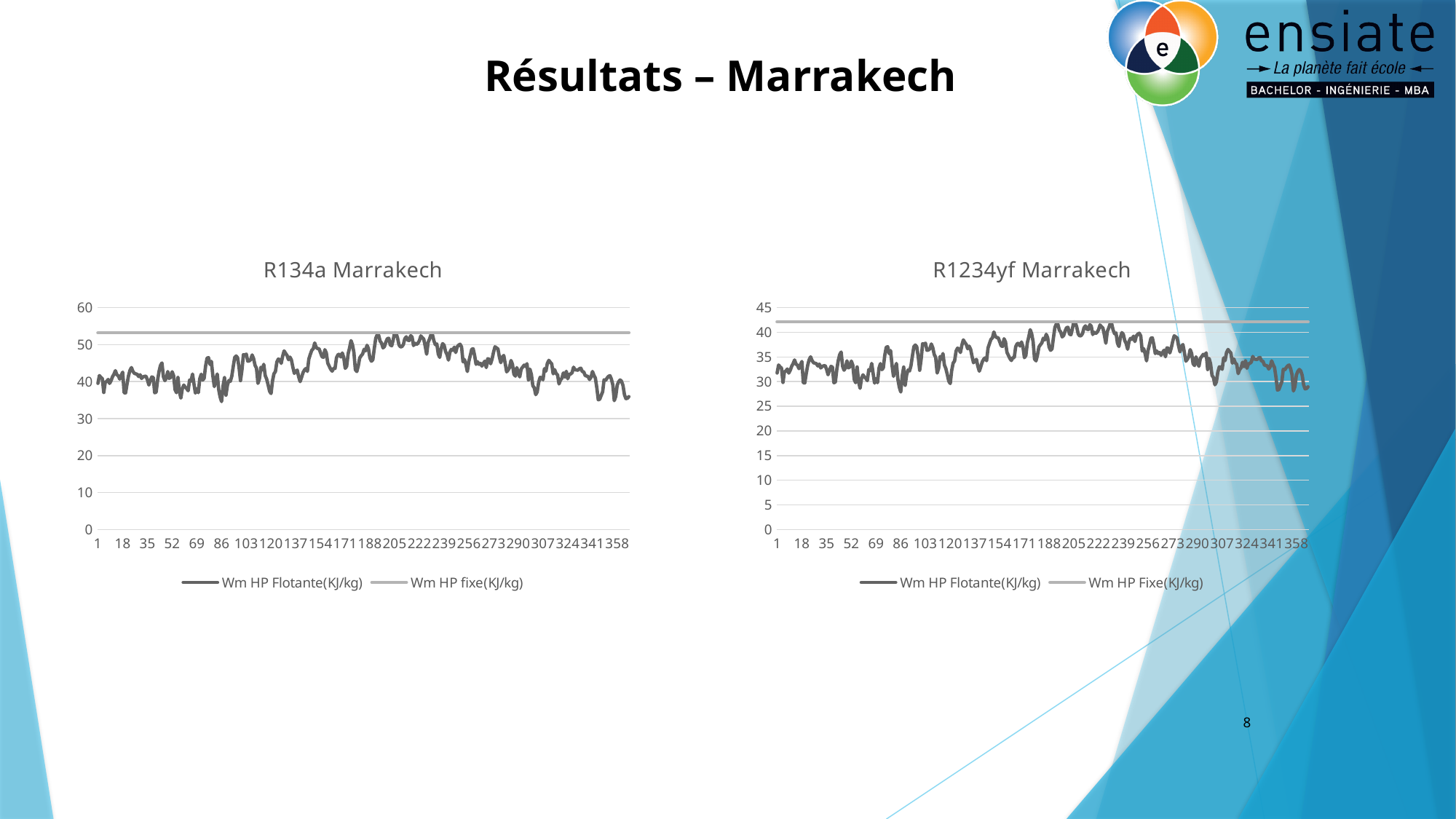
How many series does the legend of the R1234yf Marrakech chart list? 2 In the R134a Marrakech chart, which series has the higher value at point 1, Wm HP Flotante(KJ/kg) or Wm HP fixe(KJ/kg)? Wm HP fixe(KJ/kg) What are the two legend entries of the R1234yf Marrakech chart? Wm HP Flotante(KJ/kg) and Wm HP Fixe(KJ/kg) What kind of chart is the R1234yf Marrakech chart? line chart In the R1234yf Marrakech chart, does the Wm HP Flotante(KJ/kg) line generally rise or fall between point 205 and point 358? fall In the R134a Marrakech chart, is the value of Wm HP fixe(KJ/kg) greater or less than 50? greater In the R1234yf Marrakech chart, is the value of Wm HP Flotante(KJ/kg) at point 358 greater or less than 20? greater What kind of chart is the R134a Marrakech chart? line chart How many series does the legend of the R134a Marrakech chart list? 2 In the R1234yf Marrakech chart, is the value of Wm HP Fixe(KJ/kg) greater or less than 40? greater What is the title of the chart on the left of the slide? R134a Marrakech